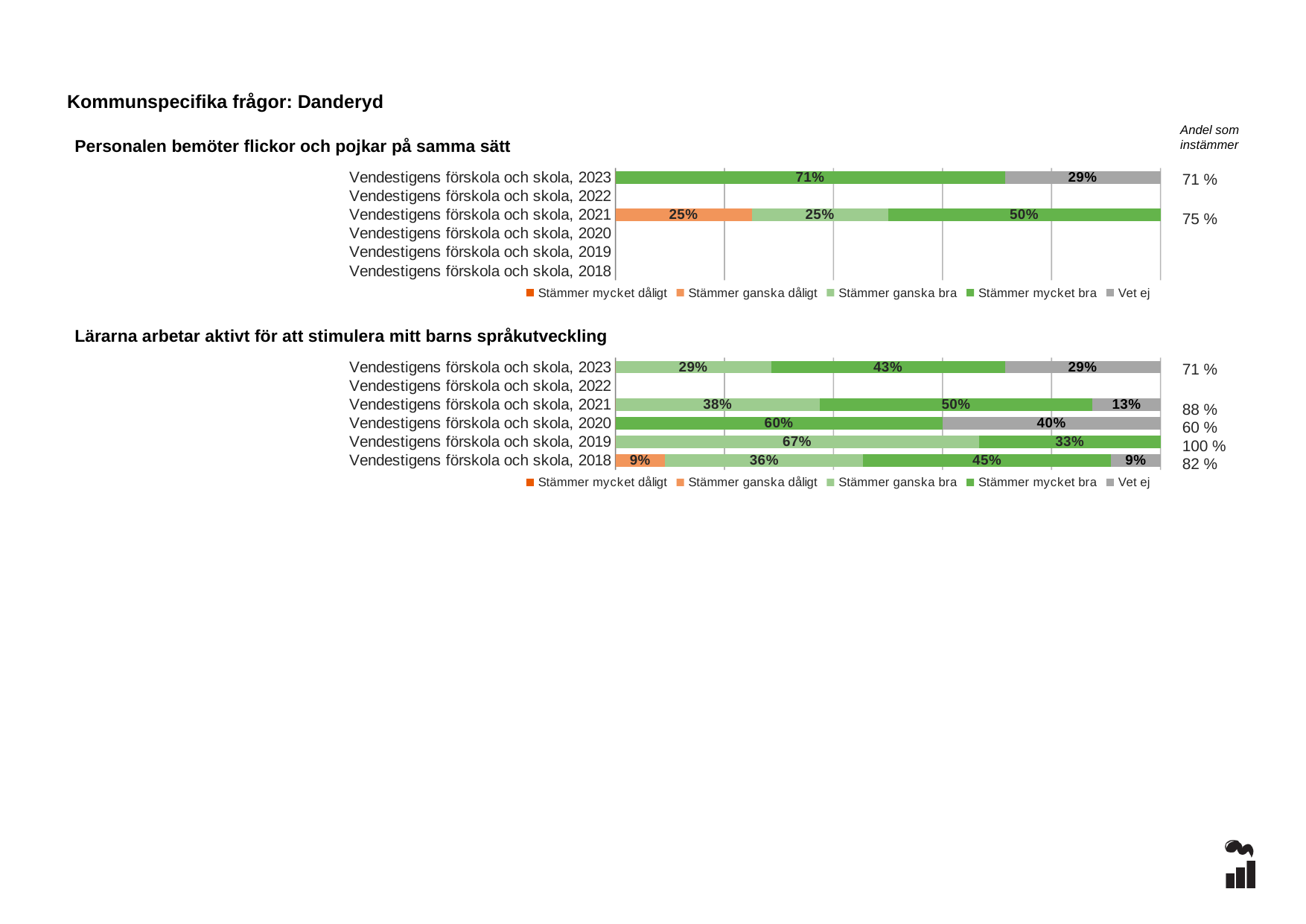
In the chart 'Lärarna arbetar aktivt för att stimulera mitt barns språkutveckling', which is larger: 'Stämmer ganska bra' for 2018 or 'Stämmer ganska bra' for 2023? 2018 In the chart 'Lärarna arbetar aktivt för att stimulera mitt barns språkutveckling', what is the value for 'Vet ej' for Vendestigens förskola och skola, 2021? 13% What kind of chart is used for 'Lärarna arbetar aktivt för att stimulera mitt barns språkutveckling'? Stacked bar chart In the chart 'Personalen bemöter flickor och pojkar på samma sätt', what is the value for 'Stämmer ganska dåligt' for Vendestigens förskola och skola, 2021? 25% In the chart 'Lärarna arbetar aktivt för att stimulera mitt barns språkutveckling', which year has the highest 'Andel som instämmer' value? Vendestigens förskola och skola, 2019 In the chart 'Lärarna arbetar aktivt för att stimulera mitt barns språkutveckling', how many category rows are listed on the y axis? 6 In the chart 'Personalen bemöter flickor och pojkar på samma sätt', how many series does the legend list? 5 In the chart 'Lärarna arbetar aktivt för att stimulera mitt barns språkutveckling', what is the value for 'Stämmer ganska bra' for Vendestigens förskola och skola, 2019? 67% In the chart 'Lärarna arbetar aktivt för att stimulera mitt barns språkutveckling', what is the difference between the 'Stämmer mycket bra' values for 2021 and 2023? 7% In the chart 'Lärarna arbetar aktivt för att stimulera mitt barns språkutveckling', what is the value for 'Stämmer mycket bra' for Vendestigens förskola och skola, 2020? 60% In the chart 'Personalen bemöter flickor och pojkar på samma sätt', what is the 'Andel som instämmer' value shown for Vendestigens förskola och skola, 2021? 75 % In the chart 'Personalen bemöter flickor och pojkar på samma sätt', what is the value for 'Stämmer mycket bra' for Vendestigens förskola och skola, 2023? 71%